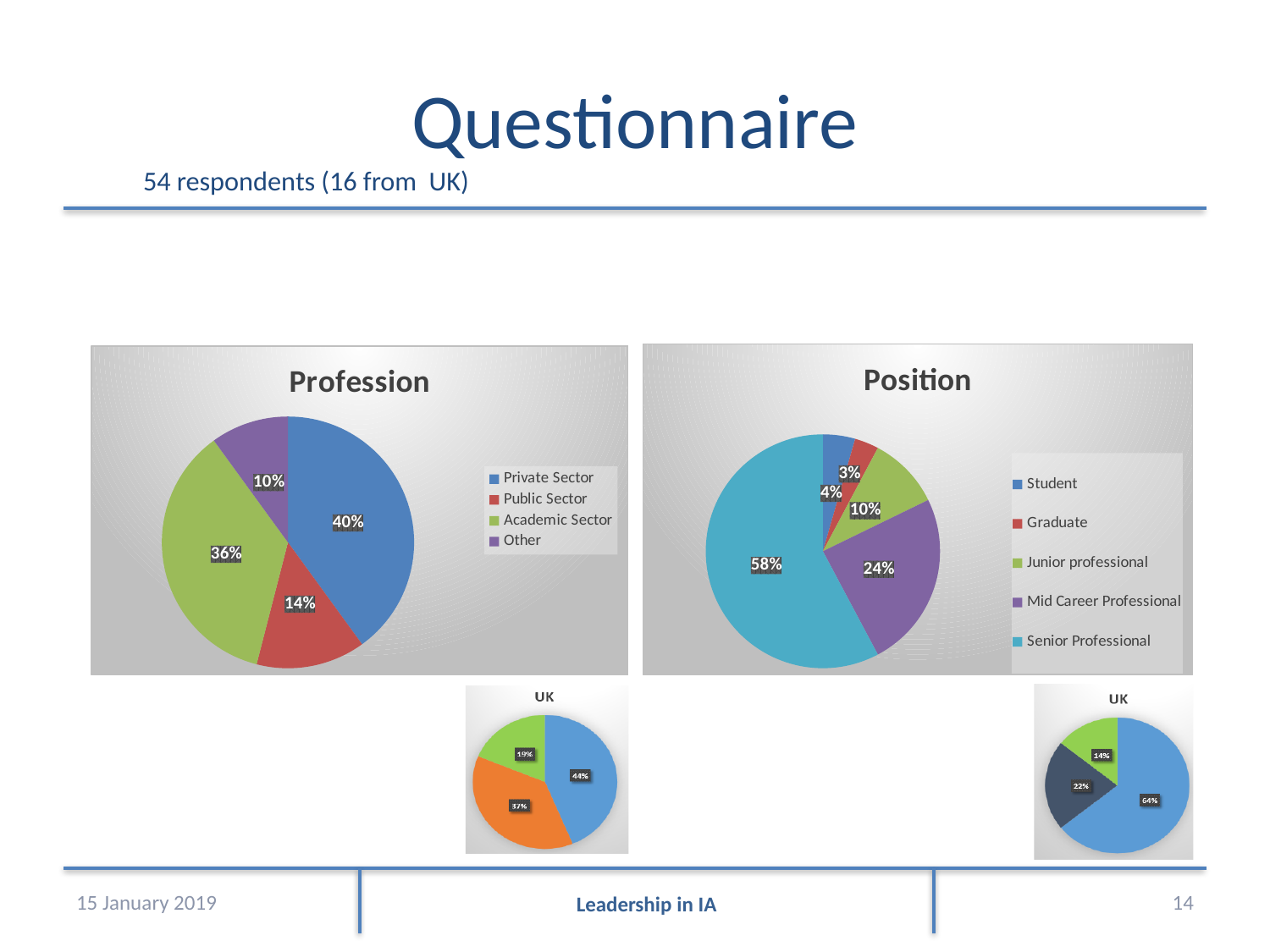
In the Profession chart, what share of respondents are in the Private Sector? 40% In the Profession chart, what is the difference between the Private Sector and Public Sector shares? 26% In the Position chart, what share of respondents are Mid Career Professionals? 24% In the small UK chart below the Profession chart, what is the largest slice's share? 44% In the Profession chart, which category has the smallest share? Other In the Position chart, what share of respondents are Senior Professionals? 58% How many categories does the legend of the Position chart list? 5 In the small UK chart below the Position chart, how many slices are there? 3 In the Position chart, which category has the largest share? Senior Professional In the Profession chart, what share of respondents are in the Academic Sector? 36% In the Position chart, which is larger, the Graduate share or the Junior professional share? Junior professional What kind of chart is the Profession chart? Pie chart